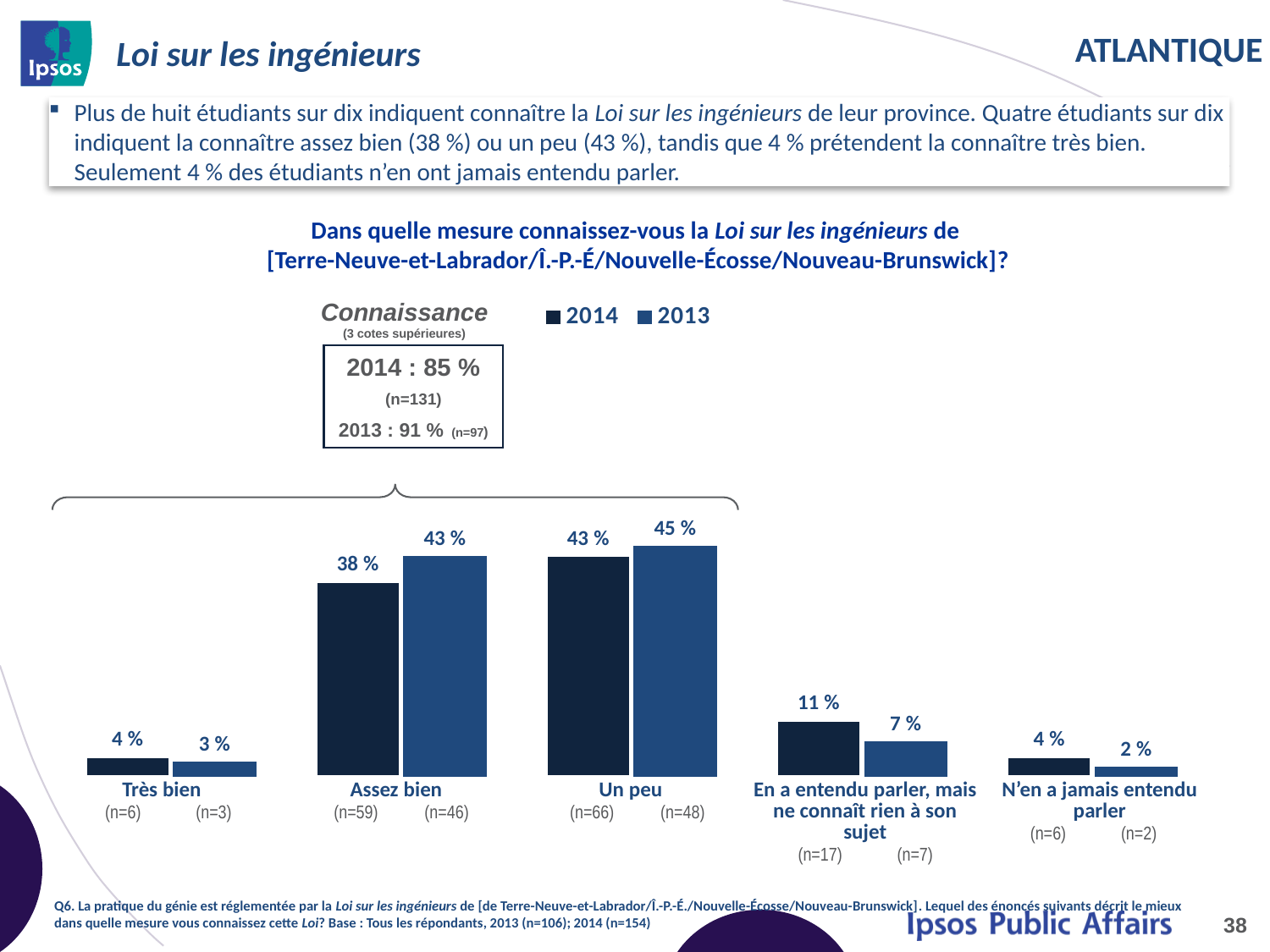
What is the 2013 value for "N'en a jamais entendu parler"? 2 % For "En a entendu parler, mais ne connaît rien à son sujet", which year has the larger value, 2014 or 2013? 2014 How many categories are shown on the x axis of the chart? 5 What is the 2013 value for "Un peu"? 45 % What is the difference between the 2013 and 2014 values for "Assez bien"? 5 % How many series does the legend list? 2 What are the two series named in the chart legend? 2014 and 2013 Which category has the highest 2014 value? Un peu Which category has the lowest 2013 value? N'en a jamais entendu parler What is the 2014 value for "En a entendu parler, mais ne connaît rien à son sujet"? 11 % What is the 2014 value for "Assez bien"? 38 % What kind of chart is shown on the slide? Bar chart